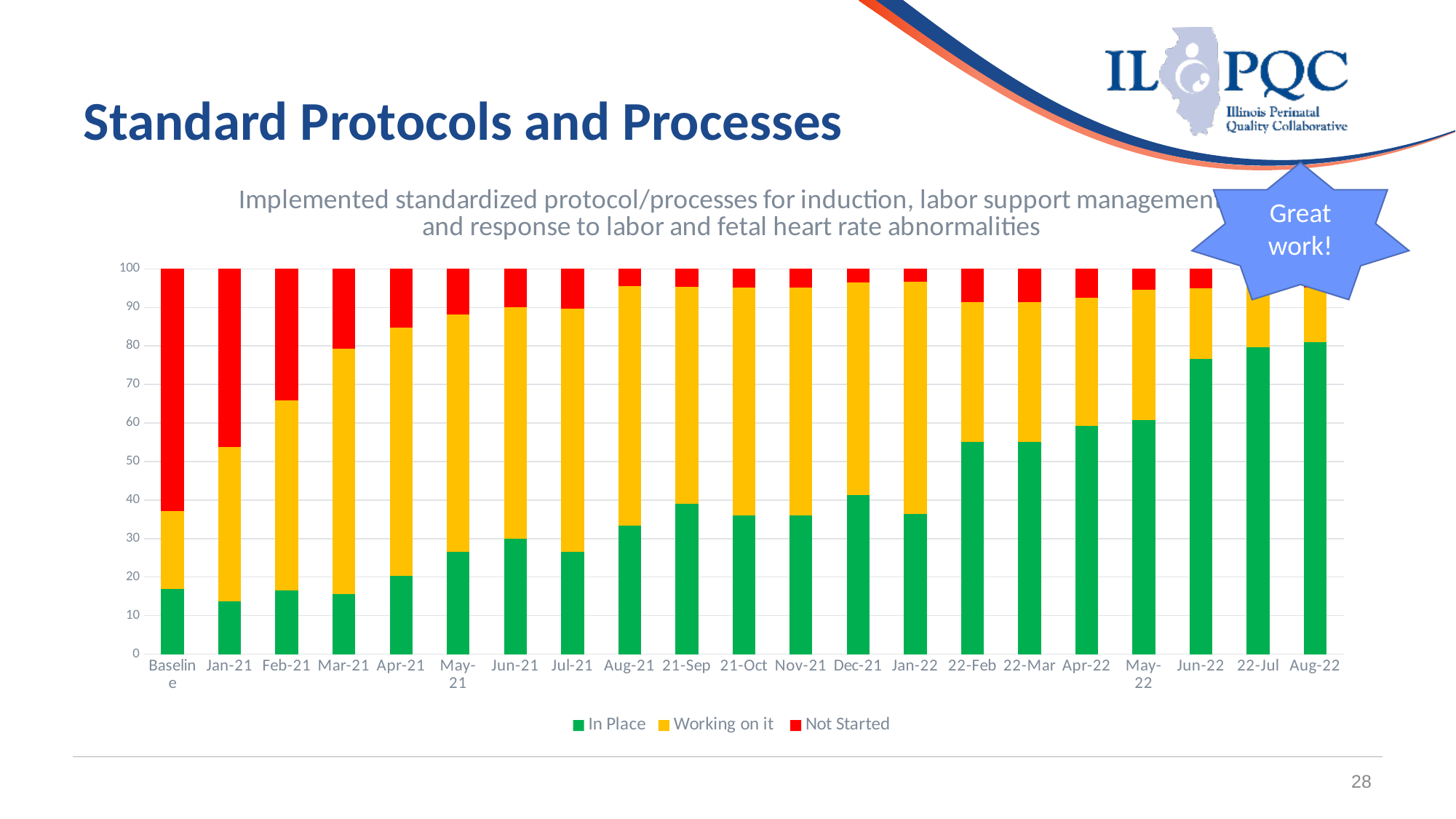
How many series does the legend list? 3 Which has a larger In Place value, Dec-21 or Jun-22? Jun-22 Is the In Place value for Baseline greater or less than 20? less Does the In Place series generally rise or fall from Baseline to Aug-22? rise How many categories are shown along the x axis? 21 Which category has the largest Not Started segment? Baseline What kind of chart is shown on the slide? Stacked bar chart Is the Not Started value for Jan-21 greater or less than 40? greater Which series is shown in green in the legend? In Place What is the total height of the stacked bar for Baseline? 100 Is the In Place value for Aug-22 greater or less than 70? greater